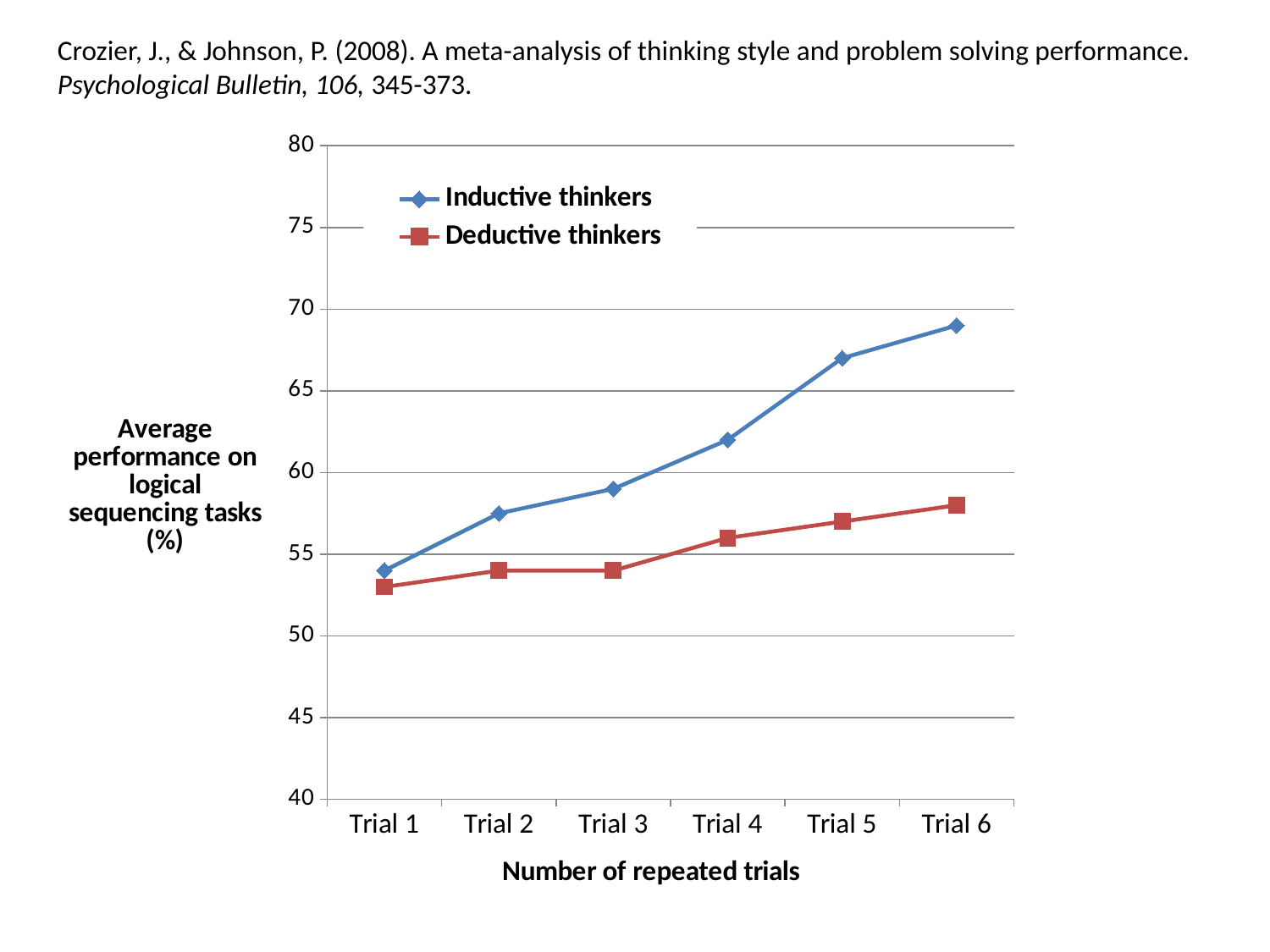
How many trials are plotted along the x axis? 6 At which trial do Inductive thinkers reach their highest value? Trial 6 Is the value for Inductive thinkers at Trial 4 greater or less than 60? greater What is the title of the x axis? Number of repeated trials How many series does the legend list? 2 Is the value for Deductive thinkers at Trial 6 greater or less than 60? less What kind of chart is shown on the slide? Line chart Which series is drawn with red square markers? Deductive thinkers At which trial do Deductive thinkers have their lowest value? Trial 1 At Trial 5, which series has the larger value, Inductive thinkers or Deductive thinkers? Inductive thinkers Do the values for Inductive thinkers rise or fall from Trial 1 to Trial 6? Rise Is the value for Inductive thinkers at Trial 6 greater or less than 65? greater